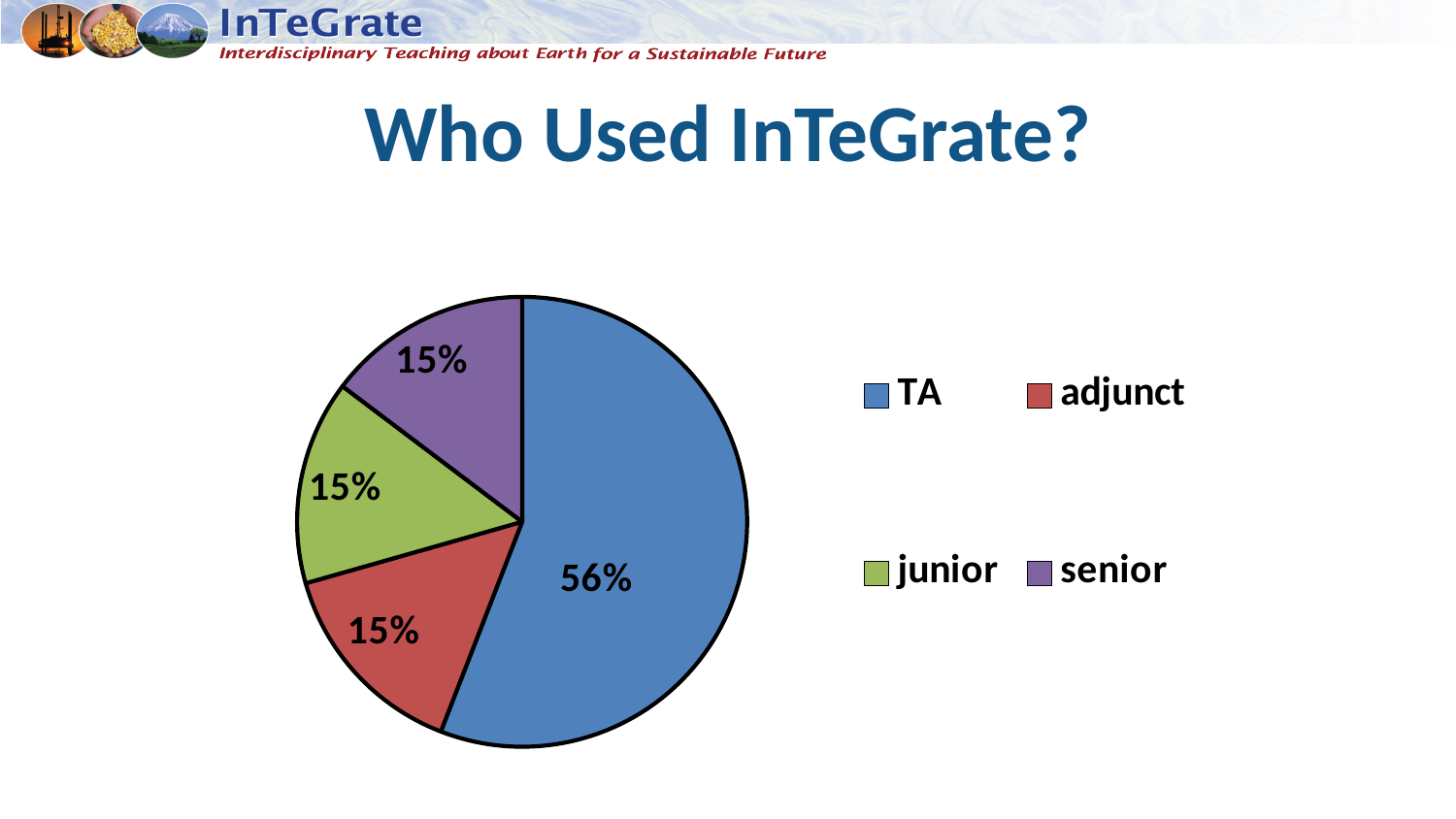
What share of the pie does TA represent? 56% What kind of chart is shown on the slide? pie chart What share of the pie does adjunct represent? 15% How many categories does the pie chart show? 4 What is the title of the chart on the slide? Who Used InTeGrate? Which category has the largest slice of the pie? TA What share of the pie does junior represent? 15% What is the difference between the TA share and the adjunct share? 41% Which colour represents the TA slice in the pie chart? blue How many entries does the legend list? 4 Which is larger, the share for TA or the share for senior? TA